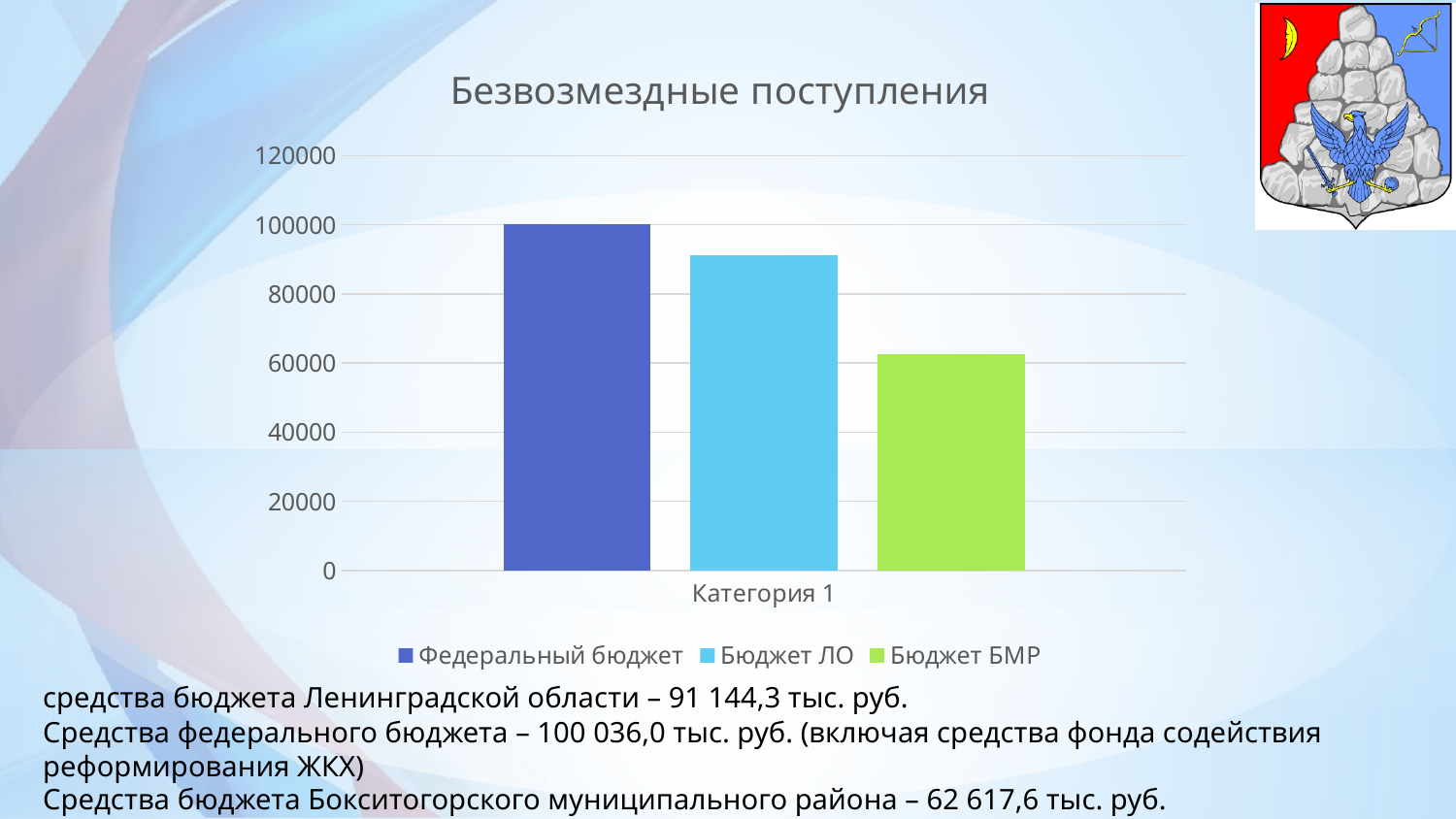
How many categories are shown on the x axis? 1 Which series has the highest bar? Федеральный бюджет What is the title of the chart? Безвозмездные поступления Is the value for Бюджет ЛО greater or less than 80000? greater Is the value for Бюджет БМР greater or less than 80000? less Is the value for Федеральный бюджет greater or less than 120000? less What colour is the bar for Бюджет БМР? green Which is larger, Федеральный бюджет or Бюджет ЛО? Федеральный бюджет Which series has the lowest bar? Бюджет БМР Which is larger, Бюджет ЛО or Бюджет БМР? Бюджет ЛО How many series does the legend list? 3 What kind of chart is shown on the slide? bar chart